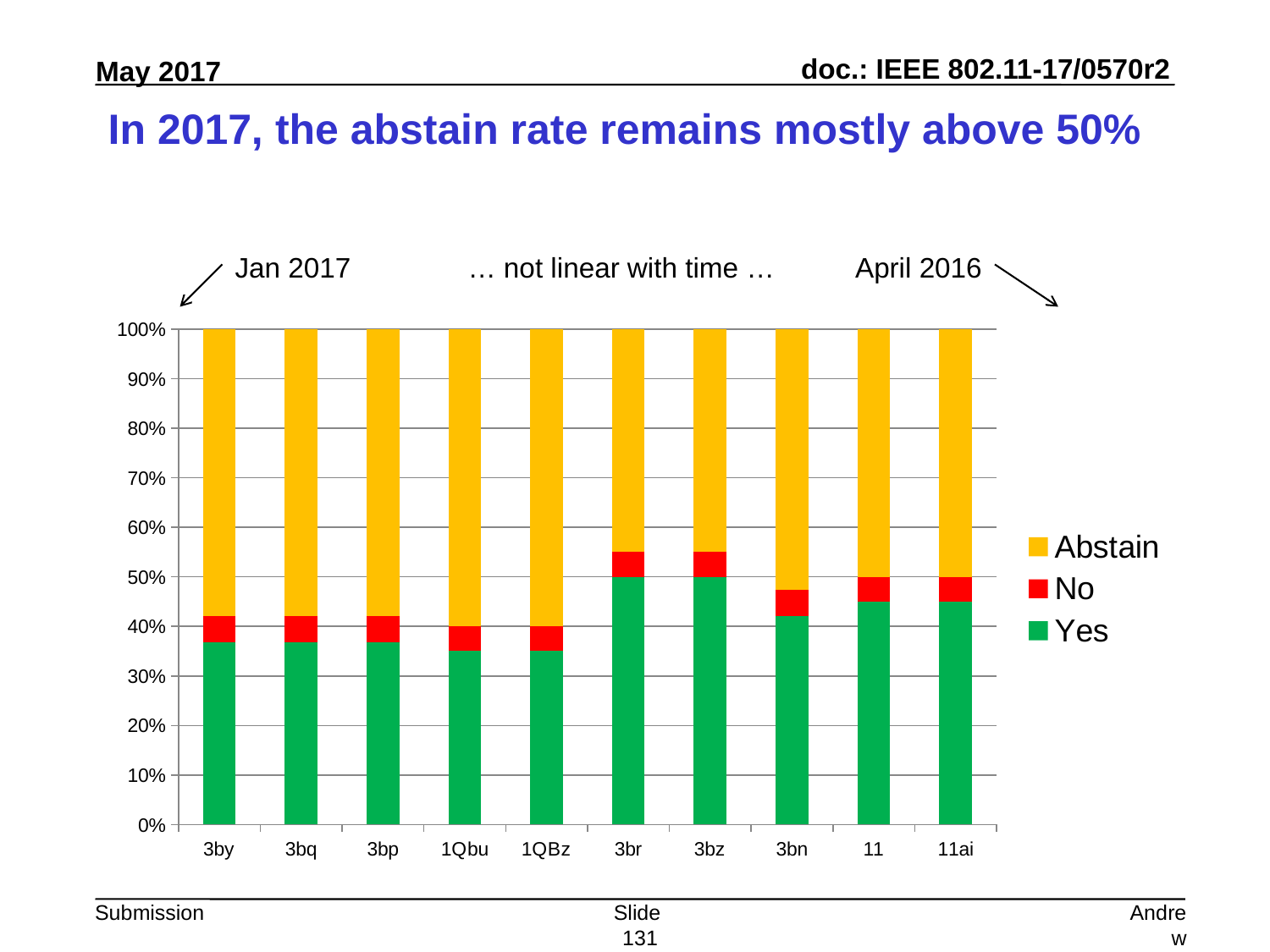
How many series does the chart's legend list? 3 What kind of chart is shown on the slide? Stacked bar chart Is the Abstain share for 3bz greater or less than 50%? less Which colour represents the Abstain series in the chart? Yellow Which has the larger Yes value, 3br or 3by? 3br Is the Abstain share for 3by greater or less than 50%? greater How many categories are shown along the x axis of the chart? 10 What is the total height of the stacked bar for 3by? 100% Is the Yes value for 3by greater or less than 40%? less Which series are listed in the chart's legend? Abstain, No, Yes